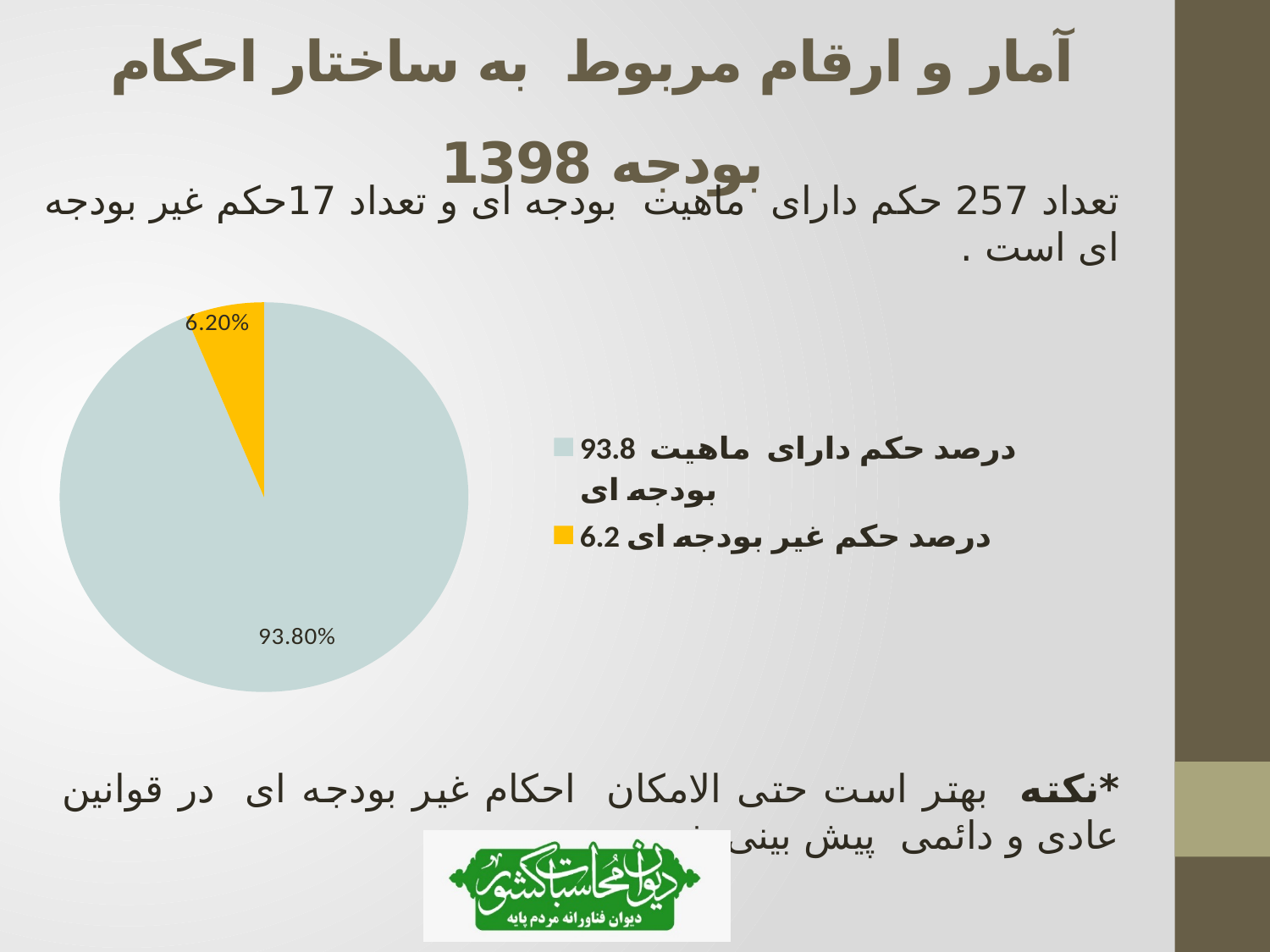
Which slice of the pie chart is the largest? درصد حکم دارای ماهیت بودجه ای What percentage is shown on the data label of the larger slice of the pie chart? 93.80% What is the data label of the slice for 'درصد حکم دارای ماهیت بودجه ای'? 93.80% Which slice of the pie chart is the smallest? درصد حکم غیر بودجه ای What is the difference between the two slice percentages shown on the pie chart? 87.60% What is the data label of the slice for 'درصد حکم غیر بودجه ای'? 6.20% How many slices does the pie chart have? 2 What kind of chart is shown on the slide? pie chart Which is larger in the pie chart: the slice for 'درصد حکم غیر بودجه ای' or the slice for 'درصد حکم دارای ماهیت بودجه ای'? درصد حکم دارای ماهیت بودجه ای What colour is the slice for 'درصد حکم غیر بودجه ای' in the pie chart? yellow What percentage is shown on the data label of the yellow slice of the pie chart? 6.20% How many entries does the legend of the pie chart list? 2